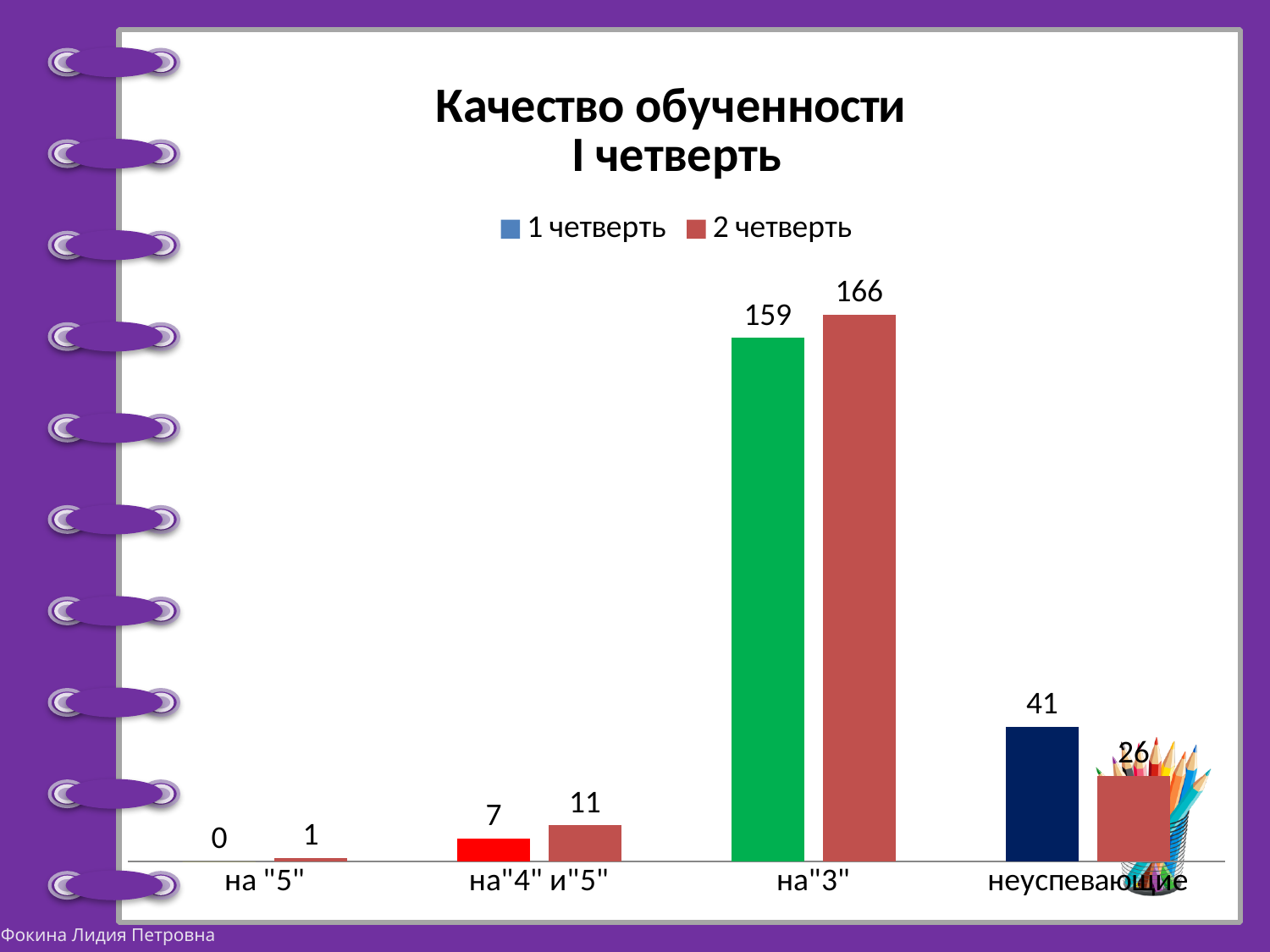
What is the value for "на"3"" in the 1 четверть series? 159 What is the value for "на"3"" in the 2 четверть series? 166 How many categories are shown on the x axis? 4 What kind of chart is shown on the slide? bar chart Which category has the highest value in the 2 четверть series? на"3" For "неуспевающие", which series has the larger value, 1 четверть or 2 четверть? 1 четверть What is the value for "неуспевающие" in the 1 четверть series? 41 What is the value for "на"4" и"5"" in the 2 четверть series? 11 How many series does the legend list? 2 What is the difference between the 2 четверть and 1 четверть values for "на"3""? 7 Which category has the lowest value in the 1 четверть series? на "5" What is the value for "на "5"" in the 1 четверть series? 0